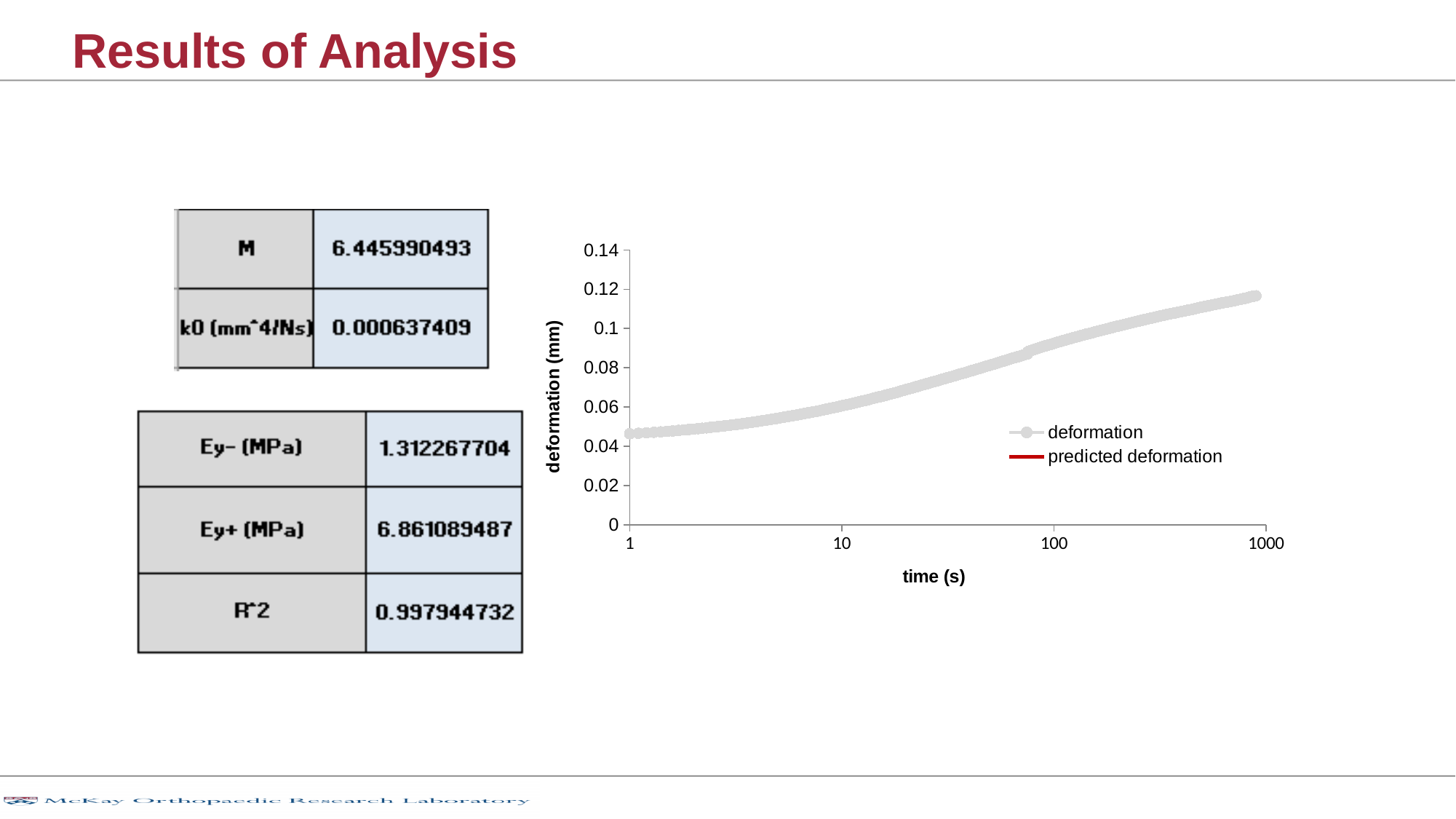
Is the deformation value at time 1 s greater or less than 0.06? less What kind of chart is shown on the slide? line chart Is the deformation value at time 100 s greater or less than 0.06? greater Is the deformation value at time 10 s greater or less than 0.08? less Does the deformation rise or fall as time increases along the x axis? rise What is the label of the y axis of the chart? deformation (mm) How many series does the chart legend list? 2 What are the two series named in the chart legend? deformation, predicted deformation